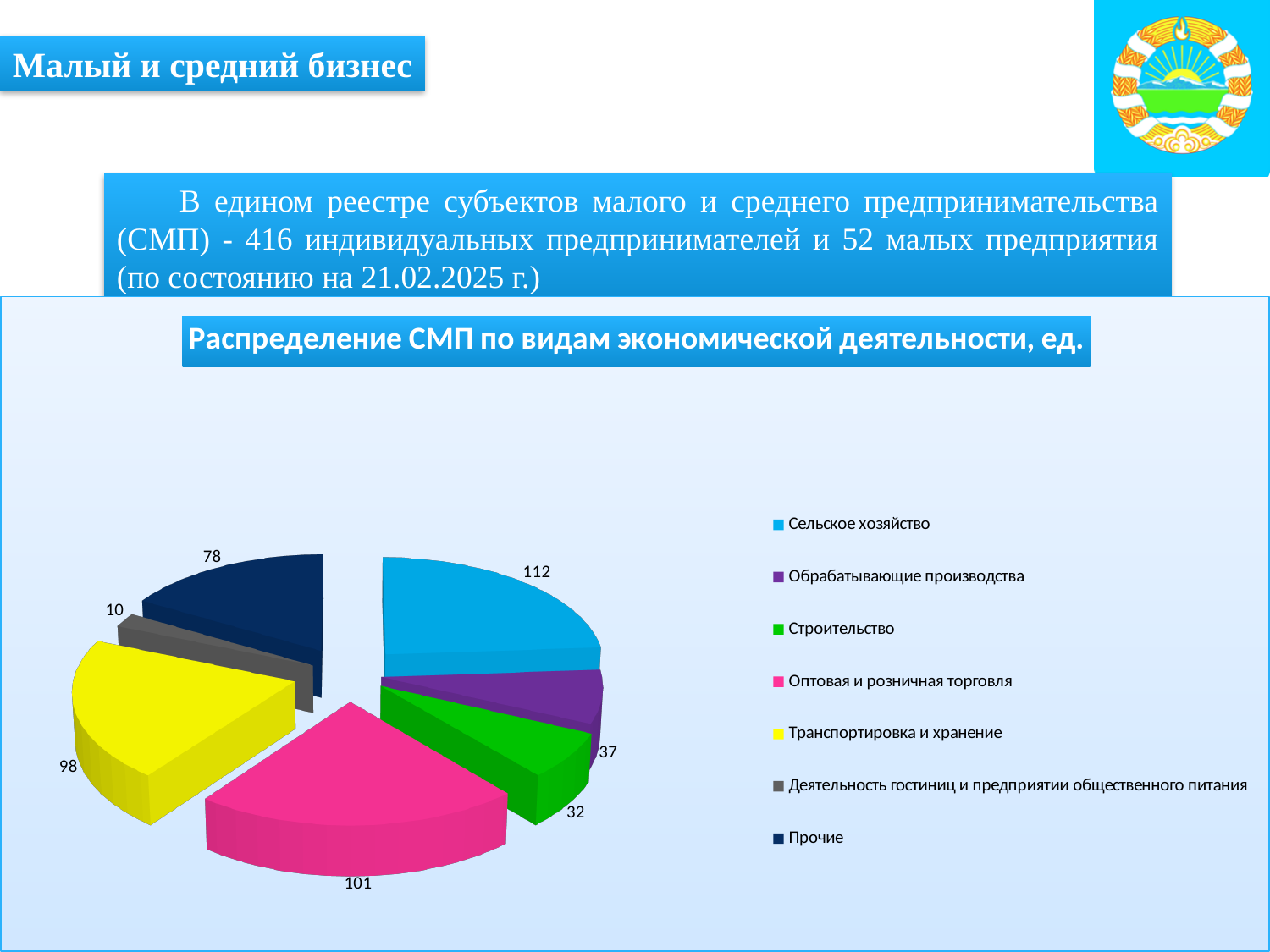
What kind of chart is shown on the slide? pie chart What is the value for Транспортировка и хранение? 98 Which is larger, the value for Оптовая и розничная торговля or the value for Транспортировка и хранение? Оптовая и розничная торговля What is the title of the chart? Распределение СМП по видам экономической деятельности, ед. What is the difference between the values for Обрабатывающие производства and Строительство? 5 What is the value for Прочие? 78 How many categories does the pie chart have? 7 What is the value for Деятельность гостиниц и предприятий общественного питания? 10 What is the value for Оптовая и розничная торговля? 101 Which category has the highest value? Сельское хозяйство What is the value for Сельское хозяйство? 112 Which category has the lowest value? Деятельность гостиниц и предприятий общественного питания